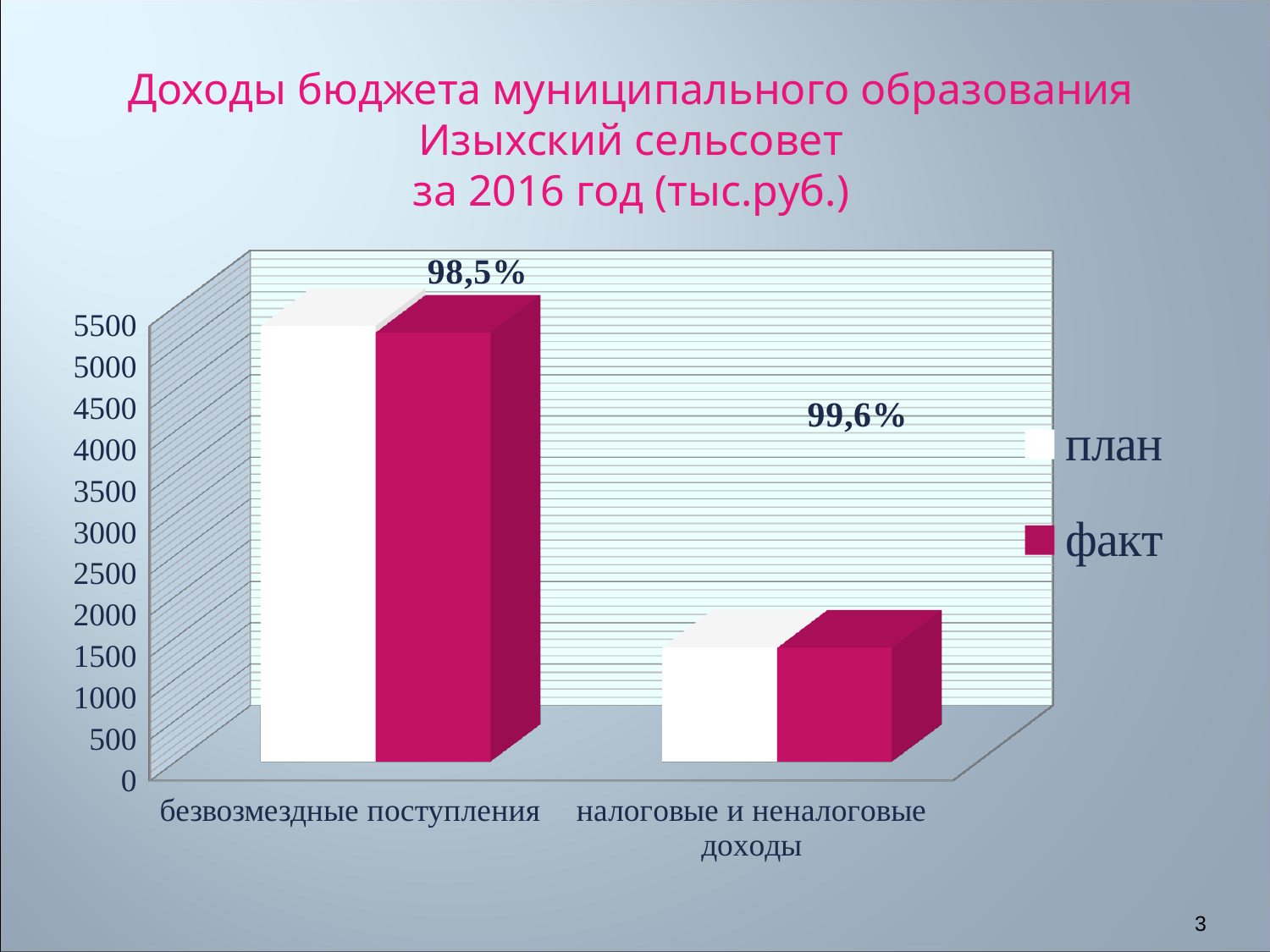
What percentage label is printed above the bars for безвозмездные поступления? 98,5% Is the план value for безвозмездные поступления greater or less than 5000? greater What percentage label is printed above the bars for налоговые и неналоговые доходы? 99,6% Which is larger: the план value for безвозмездные поступления or the план value for налоговые и неналоговые доходы? безвозмездные поступления Is the факт value for безвозмездные поступления greater or less than 4500? greater What kind of chart is shown on the slide? bar chart Which category has the highest bars in the chart? безвозмездные поступления Is the факт value for налоговые и неналоговые доходы greater or less than 2000? less Which category has the lowest bars in the chart? налоговые и неналоговые доходы How many series does the legend list? 2 What are the two series listed in the legend? план, факт How many categories are shown on the x axis of the chart? 2